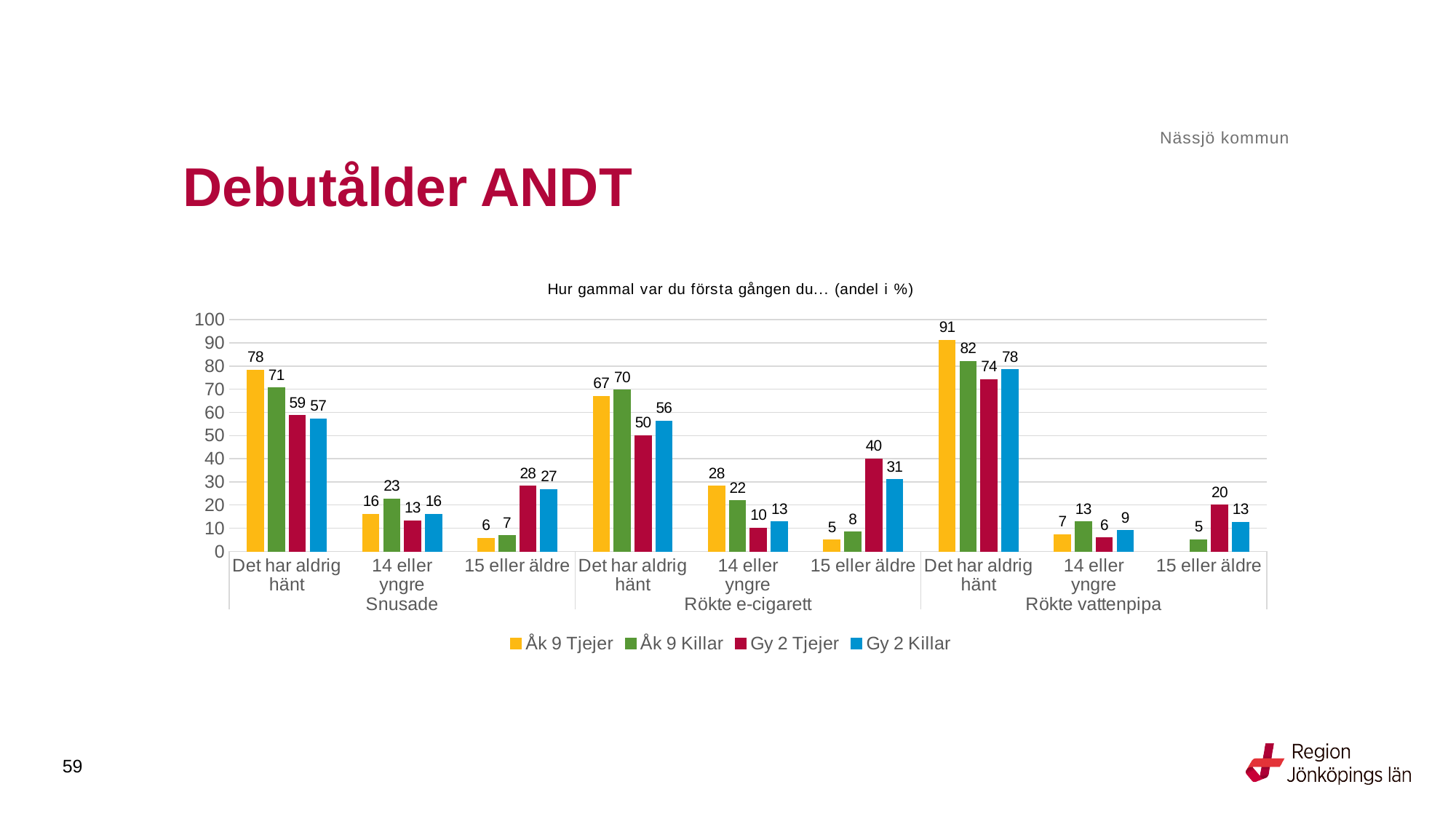
What colour represents the Gy 2 Killar series? Blue Which is larger: Åk 9 Killar or Gy 2 Killar in the '15 eller äldre' category under Rökte vattenpipa? Gy 2 Killar What is the value for Åk 9 Tjejer in the 'Det har aldrig hänt' category under Snusade? 78 Is the value for Gy 2 Tjejer in the 'Det har aldrig hänt' category under Rökte e-cigarett greater or less than 60? less What is the value for Gy 2 Killar in the 'Det har aldrig hänt' category under Rökte vattenpipa? 78 What is the value for Gy 2 Tjejer in the '15 eller äldre' category under Rökte e-cigarett? 40 Which series has the lowest value in the '14 eller yngre' category under Rökte e-cigarett? Gy 2 Tjejer Which series has the highest value in the 'Det har aldrig hänt' category under Rökte vattenpipa? Åk 9 Tjejer What is the difference between Åk 9 Tjejer and Gy 2 Tjejer in the 'Det har aldrig hänt' category under Snusade? 19 What is the title of the chart? Hur gammal var du första gången du… (andel i %) What kind of chart is shown on the slide? Bar chart How many series does the legend list? 4